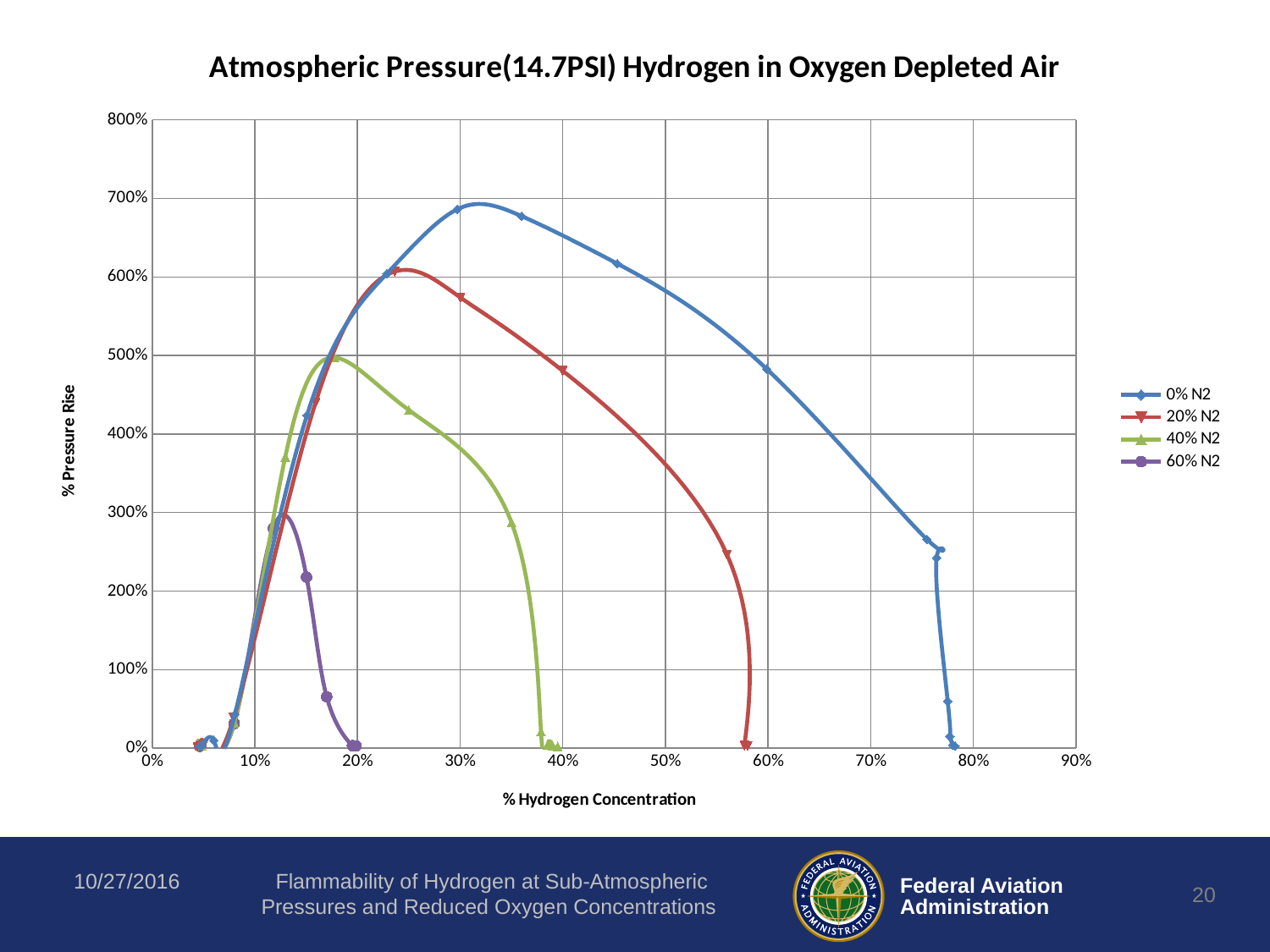
Is the peak % Pressure Rise for the 60% N2 series greater or less than 400%? less Is the peak % Pressure Rise for the 40% N2 series greater or less than 400%? greater What is the label of the x axis? % Hydrogen Concentration Which series reaches its peak at a lower % Hydrogen Concentration, 0% N2 or 60% N2? 60% N2 How many series does the legend list? 4 What kind of chart is shown on the slide? line chart Which series extends to a higher % Hydrogen Concentration, 20% N2 or 40% N2? 20% N2 Which series reaches the highest peak % Pressure Rise? 0% N2 Is the peak % Pressure Rise for the 0% N2 series greater or less than 600%? greater Which series has the lowest peak % Pressure Rise? 60% N2 What is the title of the chart? Atmospheric Pressure(14.7PSI) Hydrogen in Oxygen Depleted Air